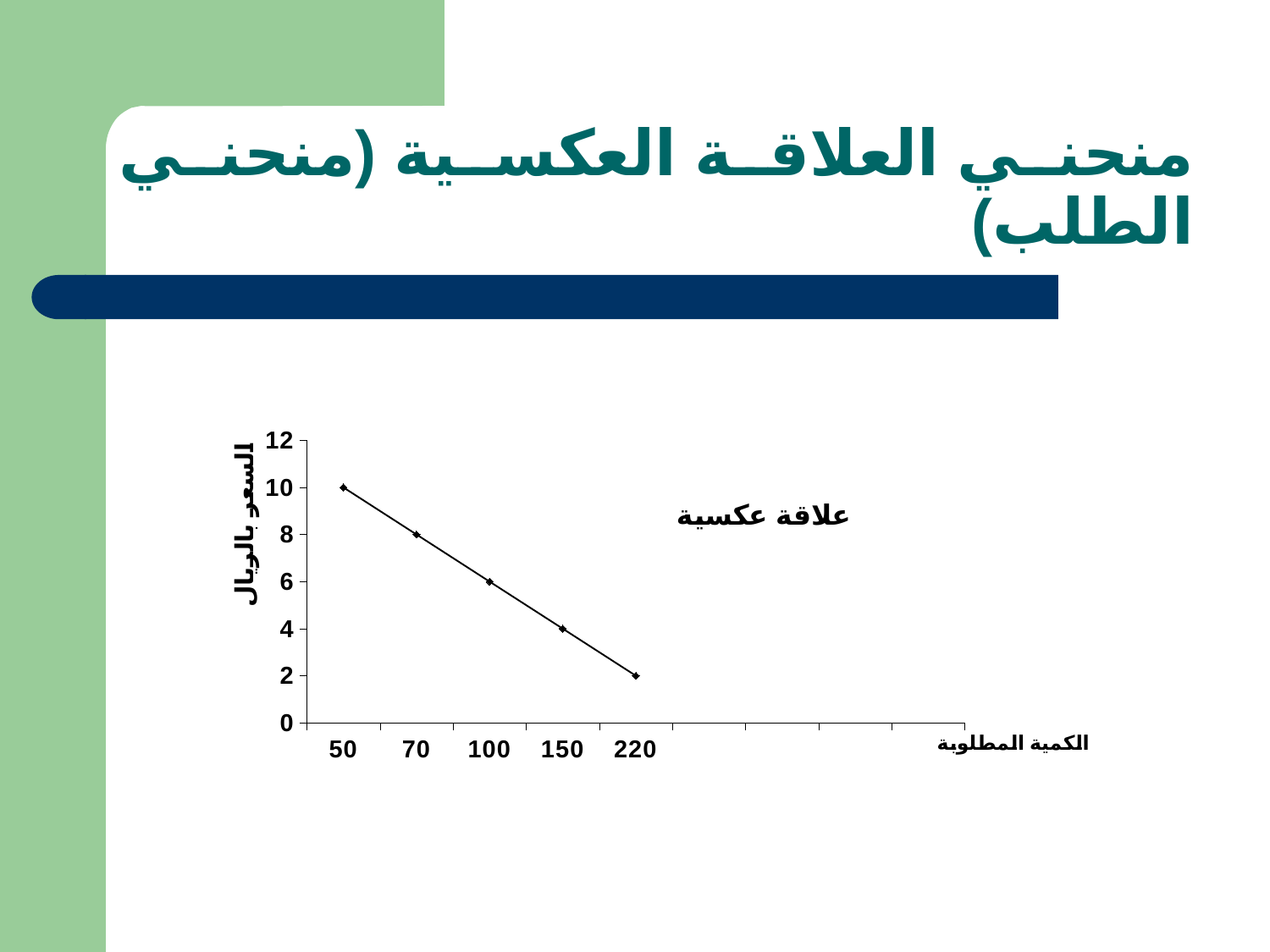
What is the difference between the price at quantity 70 and the price at quantity 150? 4 Which has a higher price: quantity 70 or quantity 150? 70 How many data points are plotted on the line? 5 What kind of chart is shown on the slide? line chart What text annotation appears inside the plot area of the chart? علاقة عكسية At which quantity demanded is the price lowest? 220 At which quantity demanded is the price highest? 50 What is the price (السعر بالريال) when the quantity demanded is 50? 10 What is the price when the quantity demanded is 220? 2 Does the price rise or fall as the quantity demanded increases along the x axis? fall What is the label on the vertical axis of the chart? السعر بالريال What is the price when the quantity demanded is 100? 6